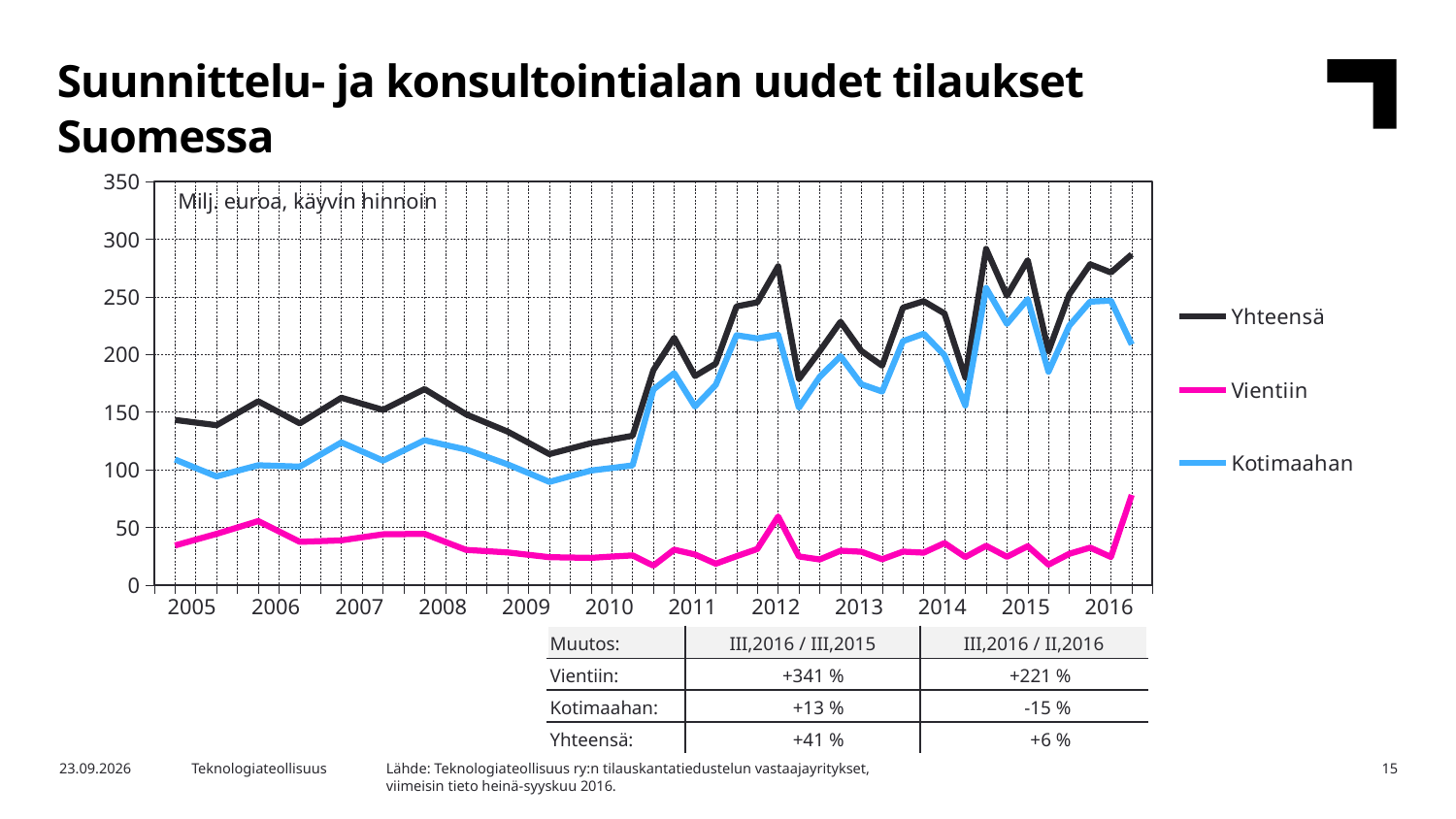
Which series are listed in the chart legend? Yhteensä, Vientiin, Kotimaahan How many series does the legend list? 3 What kind of chart is shown on the slide? Line chart Which series is larger in 2016, Kotimaahan or Vientiin? Kotimaahan Which series has the highest values throughout the chart? Yhteensä Does the Yhteensä series overall rise or fall from 2005 to 2016? rise Is the value for Vientiin in 2012 greater or less than 100? less Which series has the lowest values throughout the chart? Vientiin How many years are labelled on the x axis? 12 Is the value for Yhteensä at the start of 2005 greater or less than 100? greater Is the highest value for Yhteensä in 2014 greater or less than 250? greater What unit note is printed inside the chart area? Milj. euroa, käyvin hinnoin